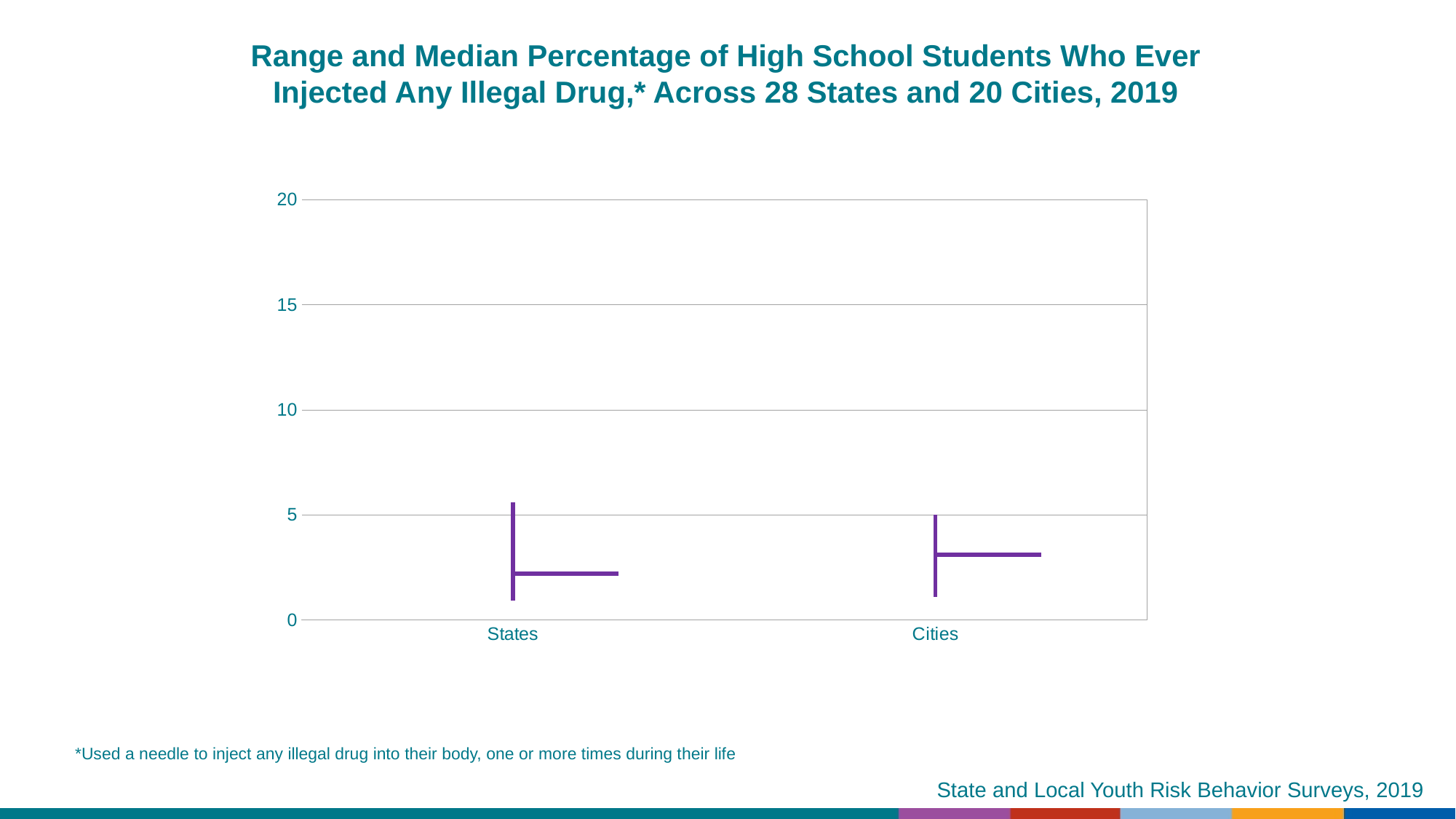
Is the median value for States greater or less than 10? less Is the median value for Cities greater or less than 5? less How many categories are shown on the x axis of the chart? 2 What is the highest value shown on the y axis? 20 Is the median value for States greater or less than 5? less According to the title, how many states and cities are included in the chart? 28 states and 20 cities What are the two categories shown on the x axis? States and Cities Which category has the lower median value? States Which category has the higher median value, States or Cities? Cities